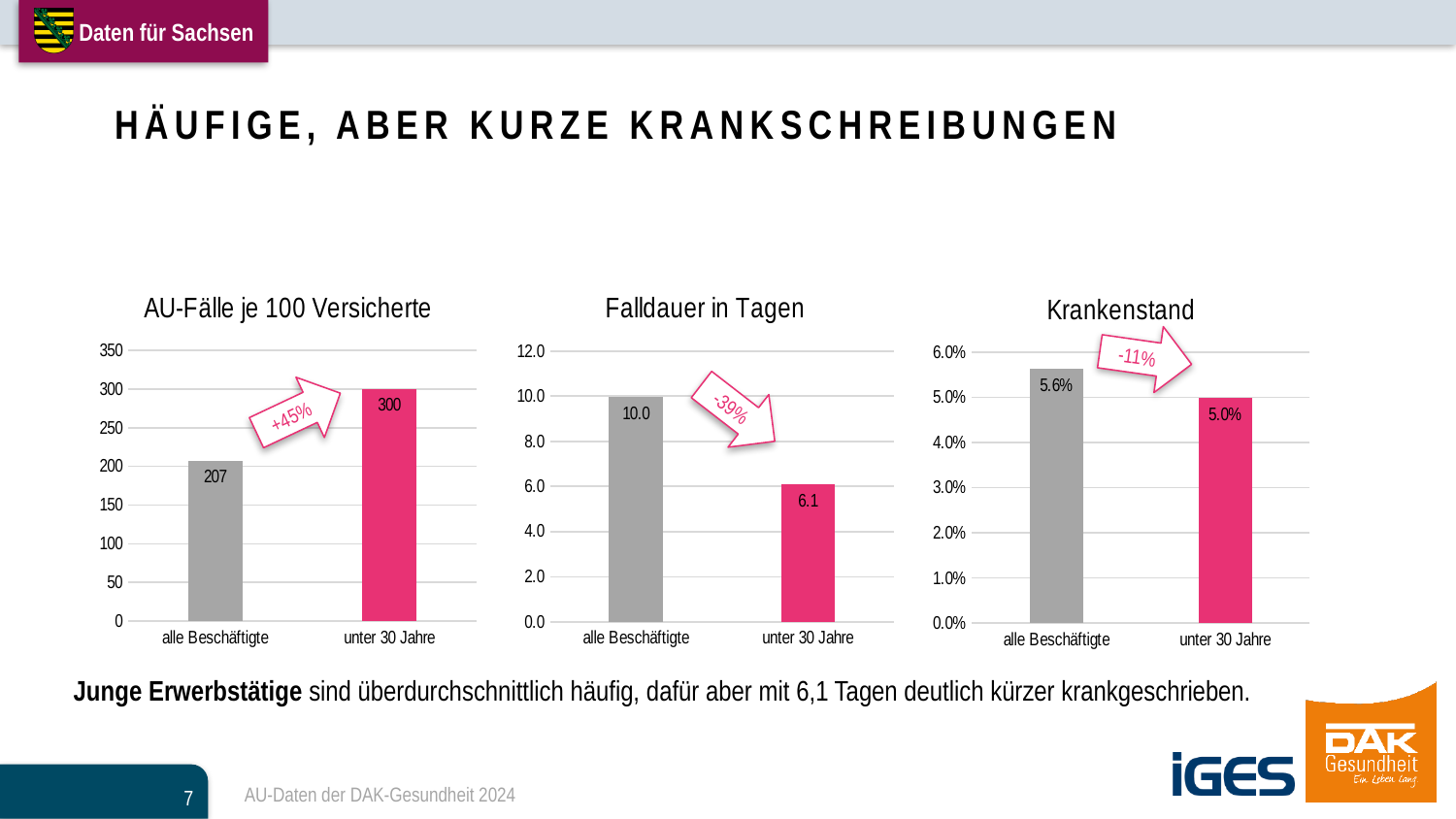
In the 'Falldauer in Tagen' chart, which category has the lowest value? unter 30 Jahre In the 'Falldauer in Tagen' chart, what is the value for 'unter 30 Jahre'? 6.1 How many categories does the 'Krankenstand' chart show? 2 In the 'Krankenstand' chart, which is larger: 'alle Beschäftigte' or 'unter 30 Jahre'? alle Beschäftigte In the 'AU-Fälle je 100 Versicherte' chart, what is the value for 'unter 30 Jahre'? 300 In the 'AU-Fälle je 100 Versicherte' chart, what is the value for 'alle Beschäftigte'? 207 In the 'AU-Fälle je 100 Versicherte' chart, what is the difference between 'unter 30 Jahre' and 'alle Beschäftigte'? 93 What type of chart is the 'Falldauer in Tagen' chart? bar chart In the 'Krankenstand' chart, what is the value for 'alle Beschäftigte'? 5.6% In the 'AU-Fälle je 100 Versicherte' chart, which category has the highest value? unter 30 Jahre What percentage change is shown by the arrow in the 'AU-Fälle je 100 Versicherte' chart? +45% In the 'Falldauer in Tagen' chart, what is the difference between 'alle Beschäftigte' and 'unter 30 Jahre'? 3.9